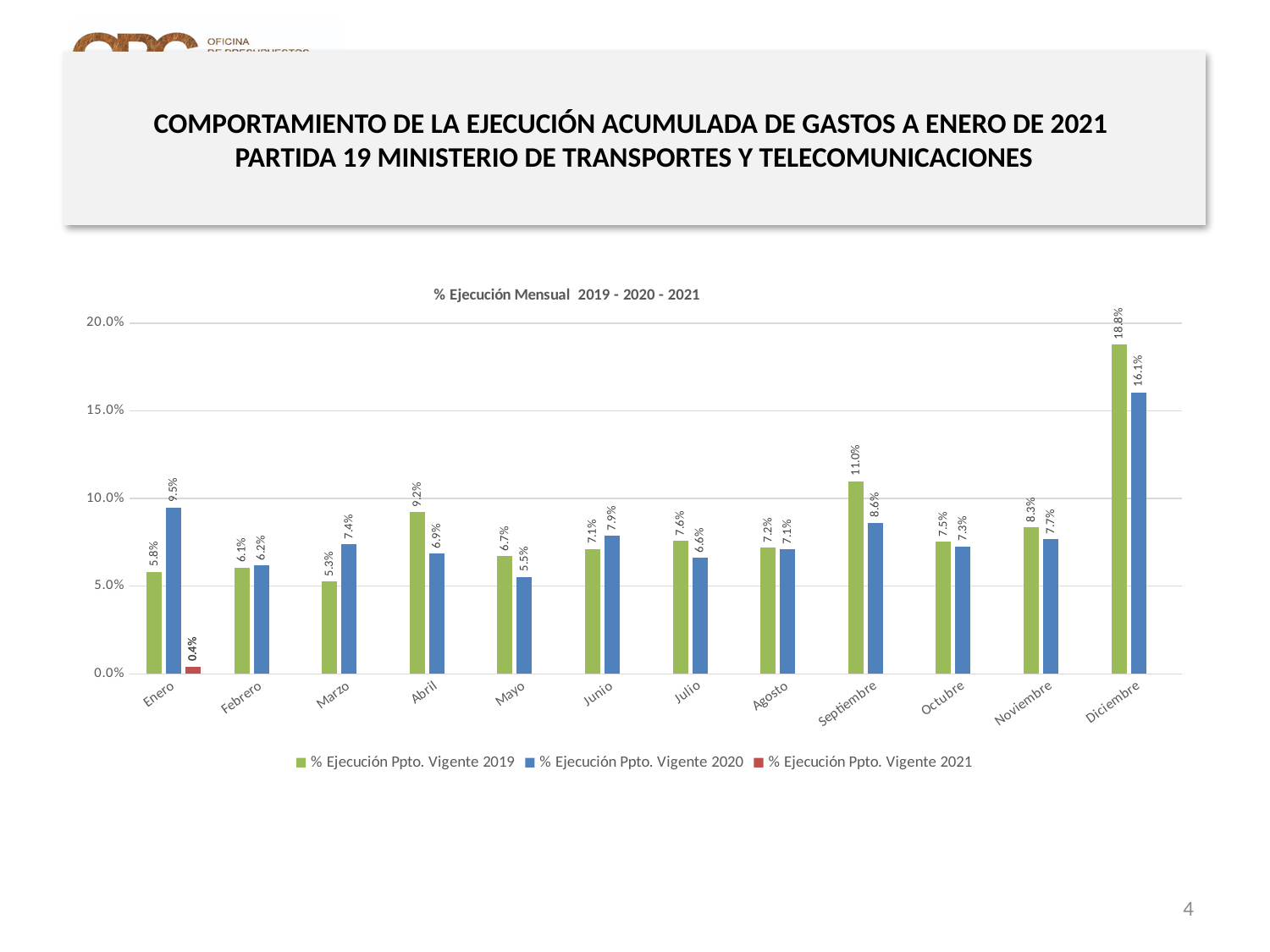
How many months are shown on the x axis? 12 Is the 2019 value for Septiembre greater or less than 10.0%? greater Which month has the lowest value for % Ejecución Ppto. Vigente 2019? Marzo What is the difference between the 2019 and 2020 values for Diciembre? 2.7% What is the value of % Ejecución Ppto. Vigente 2019 for Septiembre? 11.0% What is the value of % Ejecución Ppto. Vigente 2020 for Enero? 9.5% What is the value of % Ejecución Ppto. Vigente 2021 for Enero? 0.4% Which is larger for Abril: the 2019 value or the 2020 value? 2019 (9.2%) How many series does the legend list? 3 What is the value of % Ejecución Ppto. Vigente 2019 for Diciembre? 18.8% What kind of chart is shown on the slide? Bar chart Which month has the highest value for % Ejecución Ppto. Vigente 2020? Diciembre